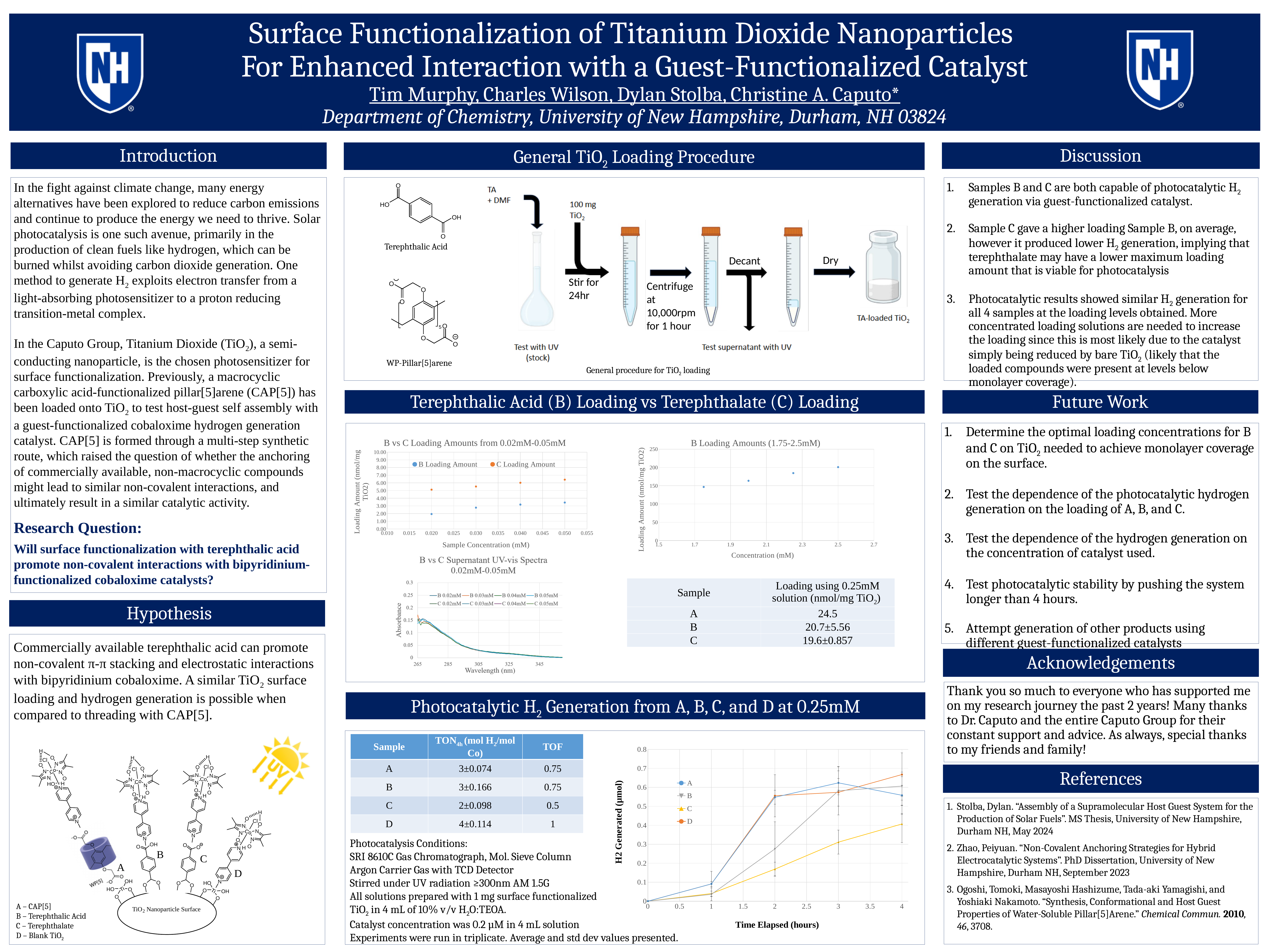
In the chart titled "B Loading Amounts (1.75-2.5mM)", how many data points are plotted? 4 In the chart titled "B Loading Amounts (1.75-2.5mM)", at which concentration is the loading amount highest? 2.5 mM In the H2 generation line chart at the bottom centre of the poster, is the value for sample C at 4 hours greater or less than 0.5? less In the chart titled "B vs C Loading Amounts from 0.02mM-0.05mM", at 0.020 mM, which is larger: the B Loading Amount or the C Loading Amount? C Loading Amount In the chart titled "B vs C Loading Amounts from 0.02mM-0.05mM", is the C Loading Amount at 0.050 mM greater or less than 6.00? greater In the chart titled "B vs C Supernatant UV-vis Spectra 0.02mM-0.05mM", what is the x-axis label? Wavelength (nm) In the chart titled "B Loading Amounts (1.75-2.5mM)", is the loading amount at 2.5 mM greater or less than 150? greater In the chart titled "B vs C Loading Amounts from 0.02mM-0.05mM", does the B Loading Amount rise or fall as sample concentration increases? Rise In the chart titled "B vs C Loading Amounts from 0.02mM-0.05mM", what kind of chart is it? Scatter chart In the H2 generation line chart at the bottom centre of the poster, which sample has the lowest H2 generated at 4 hours? C In the chart titled "B vs C Loading Amounts from 0.02mM-0.05mM", how many series does the legend list? 2 In the chart titled "B vs C Supernatant UV-vis Spectra 0.02mM-0.05mM", how many series does the legend list? 8